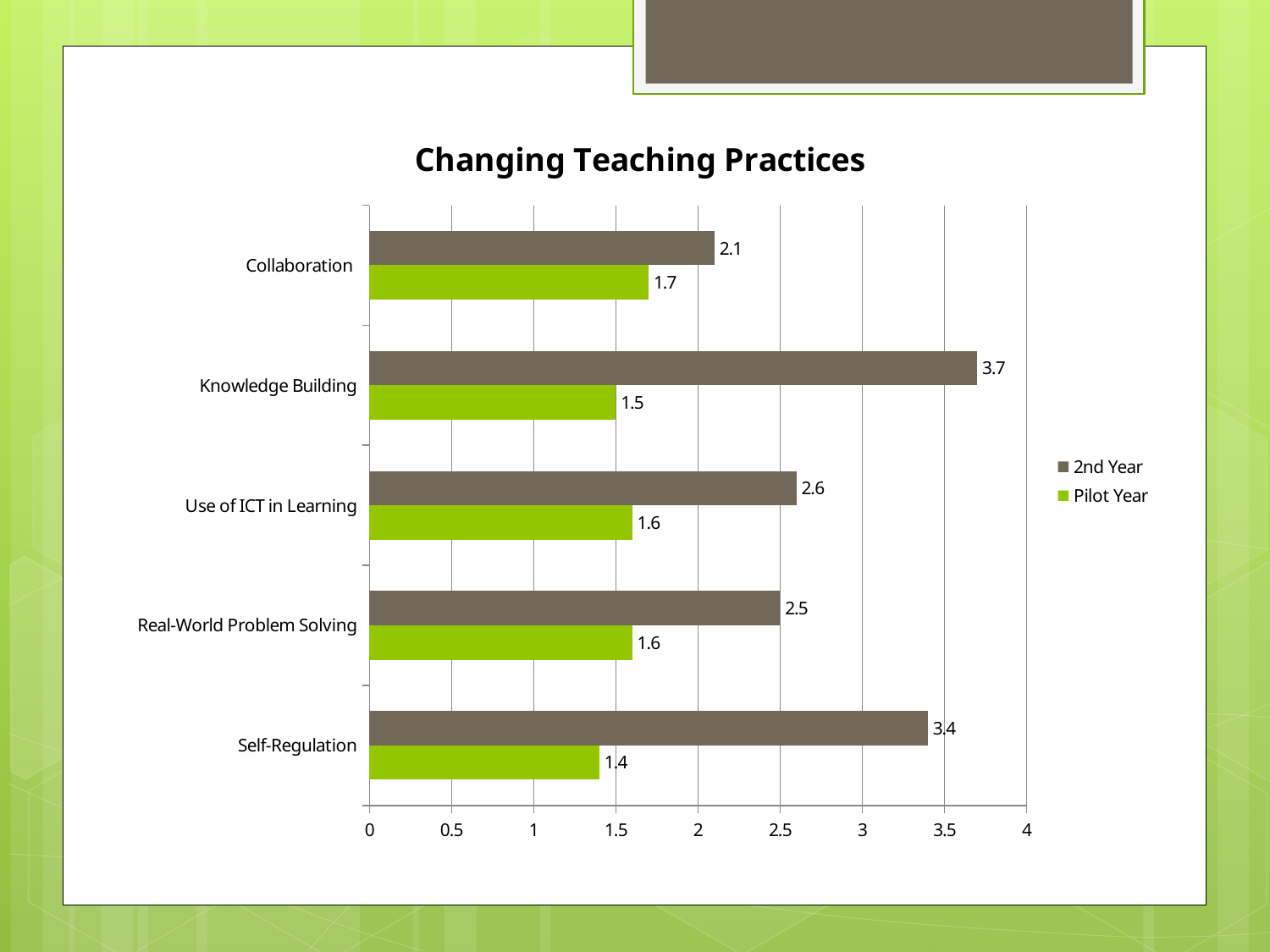
Which category has the highest 2nd Year value? Knowledge Building What is the title of the chart? Changing Teaching Practices What kind of chart is shown? bar chart Which is larger: the 2nd Year value for Use of ICT in Learning or the 2nd Year value for Real-World Problem Solving? Use of ICT in Learning Which category has the lowest Pilot Year value? Self-Regulation How many series does the legend list? 2 What is the 2nd Year value for Collaboration? 2.1 What is the 2nd Year value for Knowledge Building? 3.7 How many categories are shown on the chart? 5 What is the difference between the 2nd Year and Pilot Year values for Knowledge Building? 2.2 What is the Pilot Year value for Self-Regulation? 1.4 Is the 2nd Year value for Self-Regulation greater or less than 3? greater